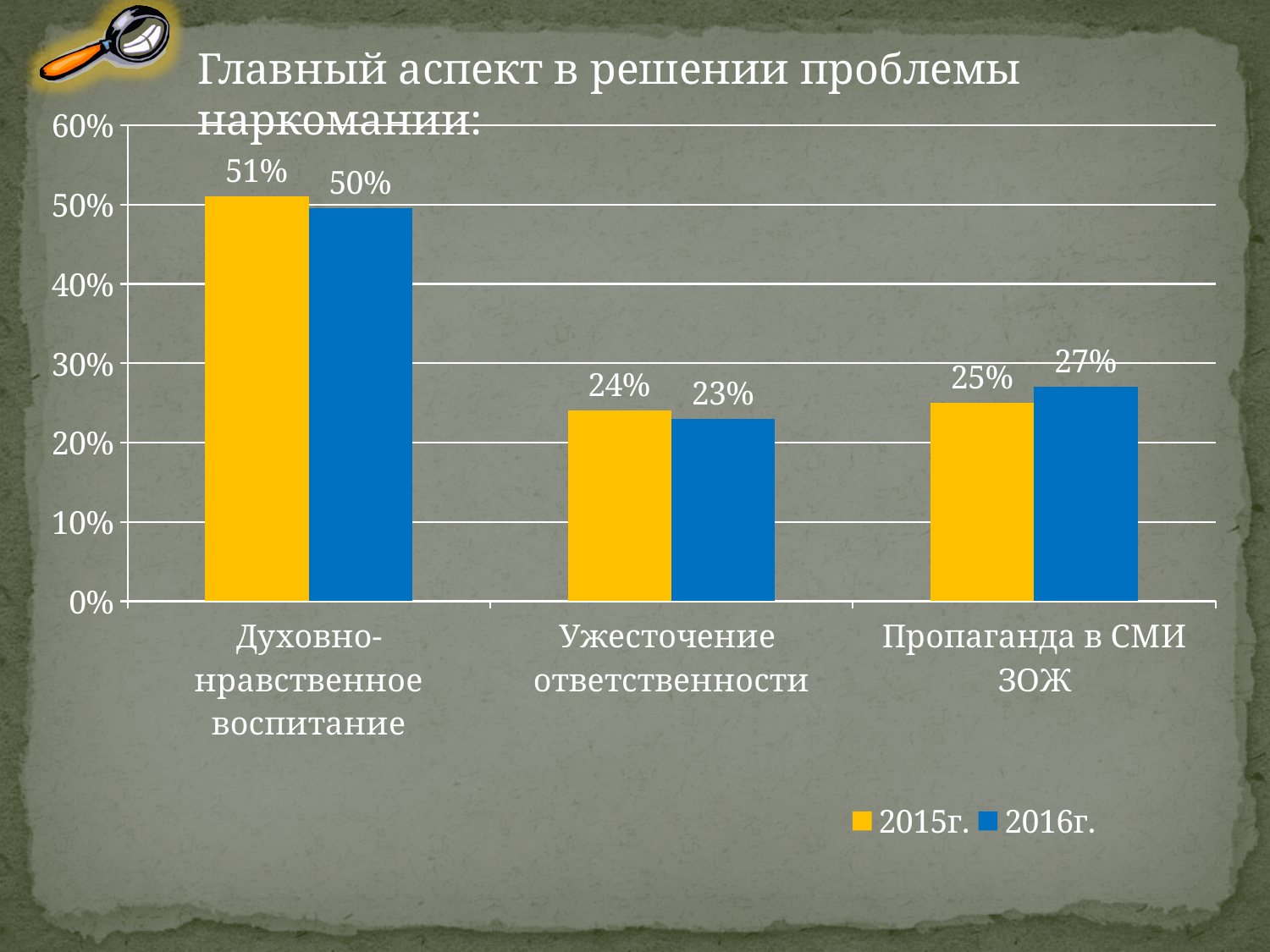
What is the difference between the 2015г. values for Духовно-нравственное воспитание and Ужесточение ответственности? 27% What is the difference between the 2015г. and 2016г. values for Пропаганда в СМИ ЗОЖ? 2% Which colour represents the 2016г. series? Blue How many series does the legend list? 2 Which category has the highest 2015г. value? Духовно-нравственное воспитание What is the 2016г. value for Пропаганда в СМИ ЗОЖ? 27% Which is larger for Пропаганда в СМИ ЗОЖ: the 2015г. value or the 2016г. value? 2016г. Which category has the lowest 2016г. value? Ужесточение ответственности What is the 2015г. value for Духовно-нравственное воспитание? 51% What is the 2016г. value for Ужесточение ответственности? 23% What kind of chart is shown on the slide? Bar chart How many categories are shown on the x axis? 3